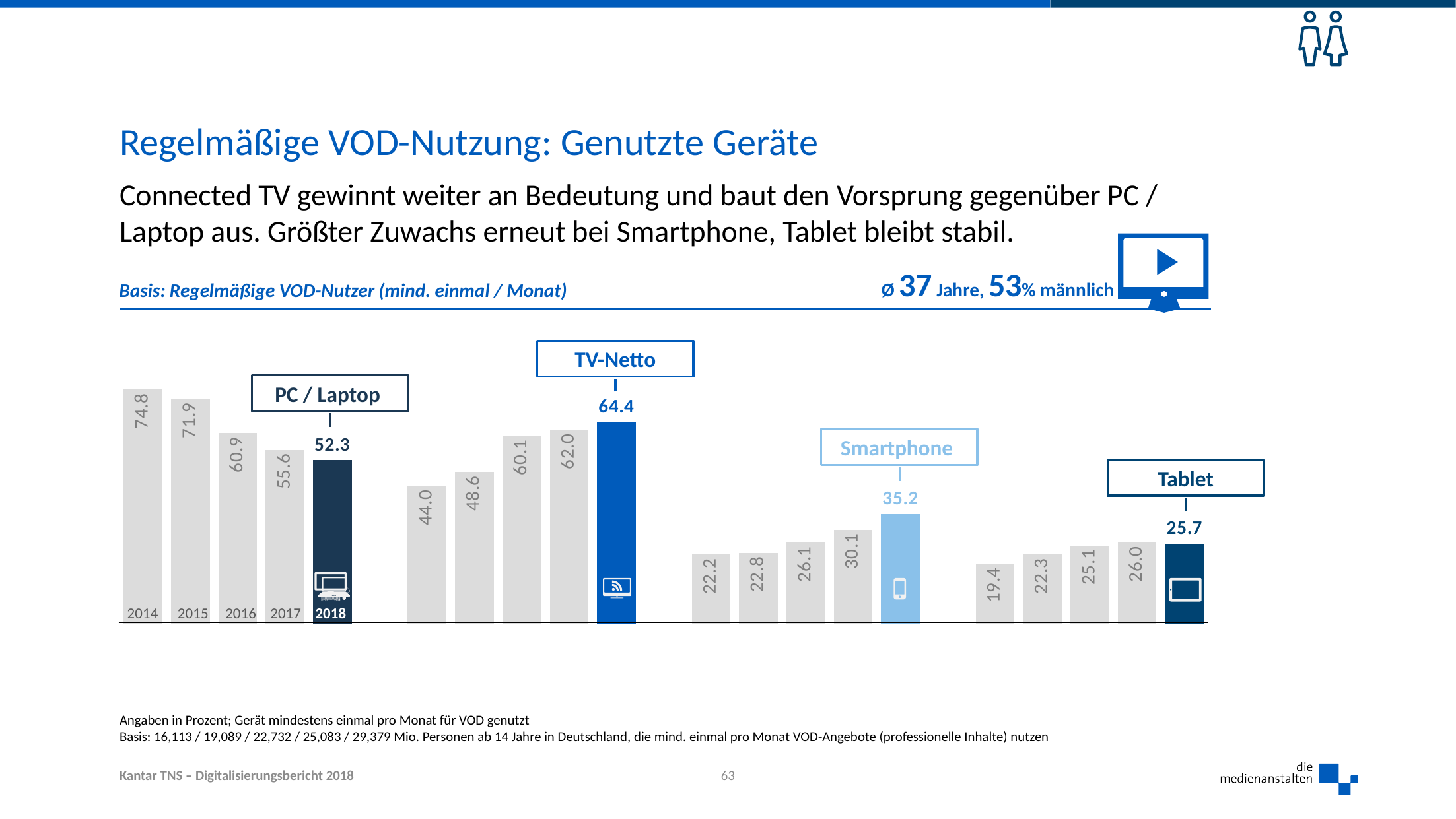
How many bars are shown in the PC / Laptop group? 5 What is the value for TV-Netto in 2018 (the highlighted bar)? 64.4 What is the value for Tablet in 2018 (the highlighted bar)? 25.7 What kind of chart is shown on the slide? bar chart Which device group has the highest 2018 value? TV-Netto Do the PC / Laptop values rise or fall from 2014 to 2018? fall What is the value for Smartphone in 2018 (the highlighted bar)? 35.2 Which is larger in 2018: the value for Smartphone or the value for Tablet? Smartphone What is the value for PC / Laptop in 2018? 52.3 What is the difference between the PC / Laptop values for 2014 and 2018? 22.5 Which device group has the lowest 2018 value? Tablet What is the value for PC / Laptop in 2014? 74.8